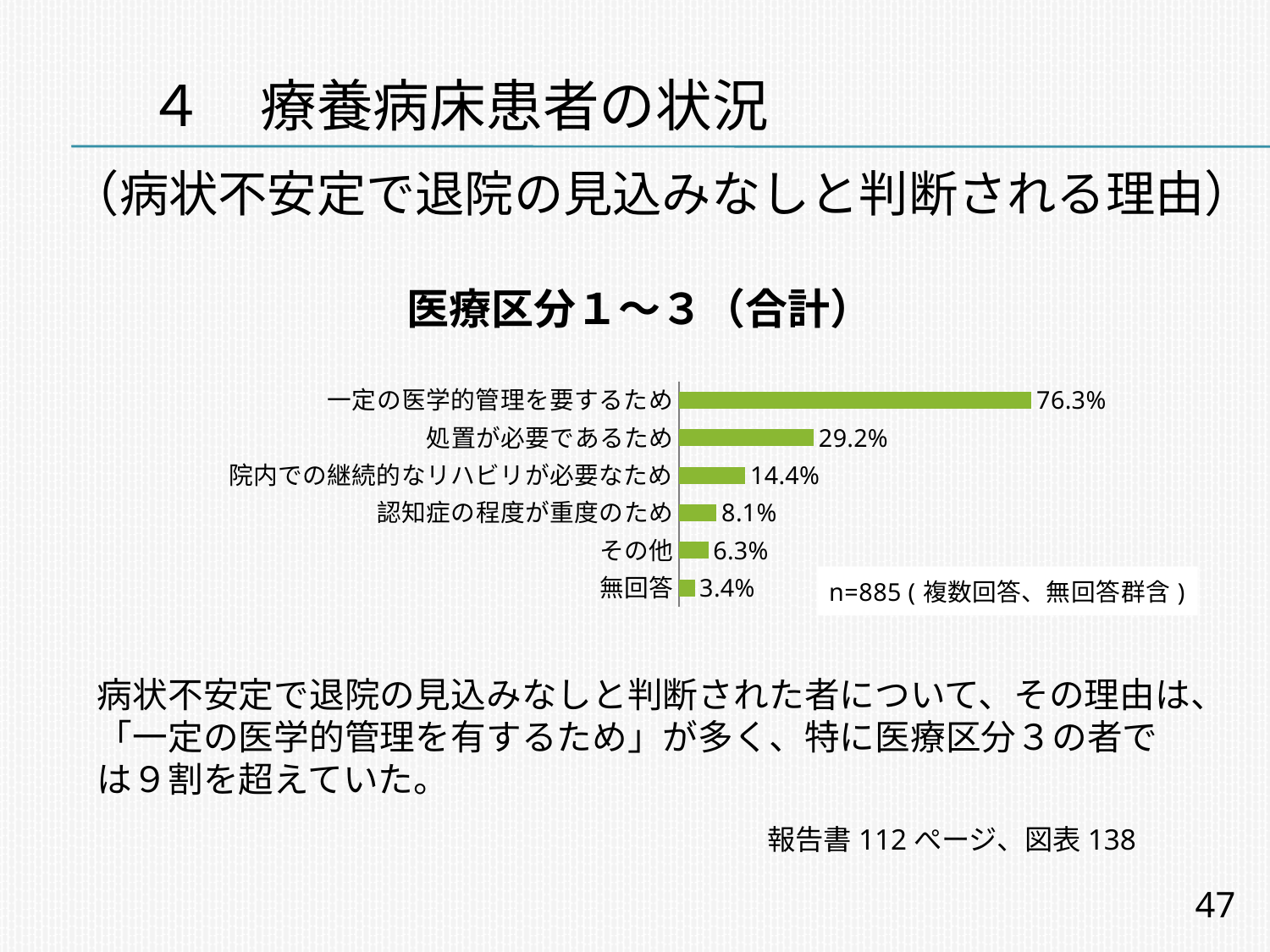
What is the sample size (n) noted on the chart? n=885 What is the value for 無回答? 3.4% What kind of chart is shown on the slide? bar chart What is the difference between the values for 一定の医学的管理を要するため and 処置が必要であるため? 47.1% Which category has the lowest value? 無回答 Which is larger, the value for 認知症の程度が重度のため or the value for その他? 認知症の程度が重度のため How many categories are shown in the chart? 6 Which category has the highest value? 一定の医学的管理を要するため What is the value for 一定の医学的管理を要するため? 76.3% What is the value for 院内での継続的なリハビリが必要なため? 14.4% What is the value for 処置が必要であるため? 29.2% What is the title of the chart? 医療区分１～３（合計）